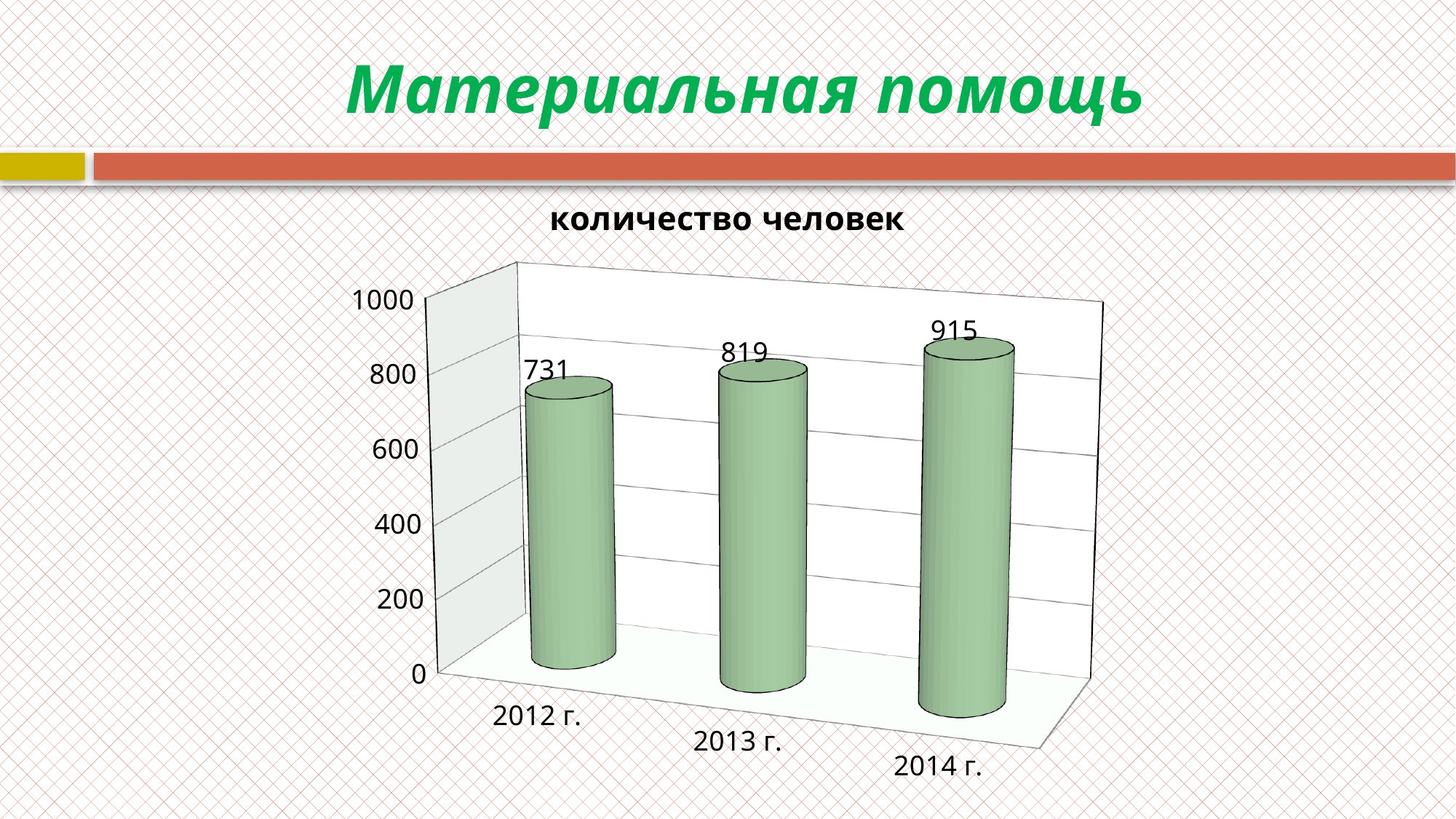
What is the difference between the values for 2014 г. and 2012 г.? 184 Which year has the highest value? 2014 г. What is the value for 2014 г.? 915 Is the value for 2012 г. greater or less than 800? less Do the values rise or fall from 2012 г. to 2014 г.? rise What kind of chart is shown on the slide? bar chart Which is larger, the value for 2013 г. or the value for 2014 г.? 2014 г. What is the value for 2012 г.? 731 Which year has the lowest value? 2012 г. How many categories are shown on the x axis? 3 What is the difference between the values for 2013 г. and 2012 г.? 88 What is the value for 2013 г.? 819